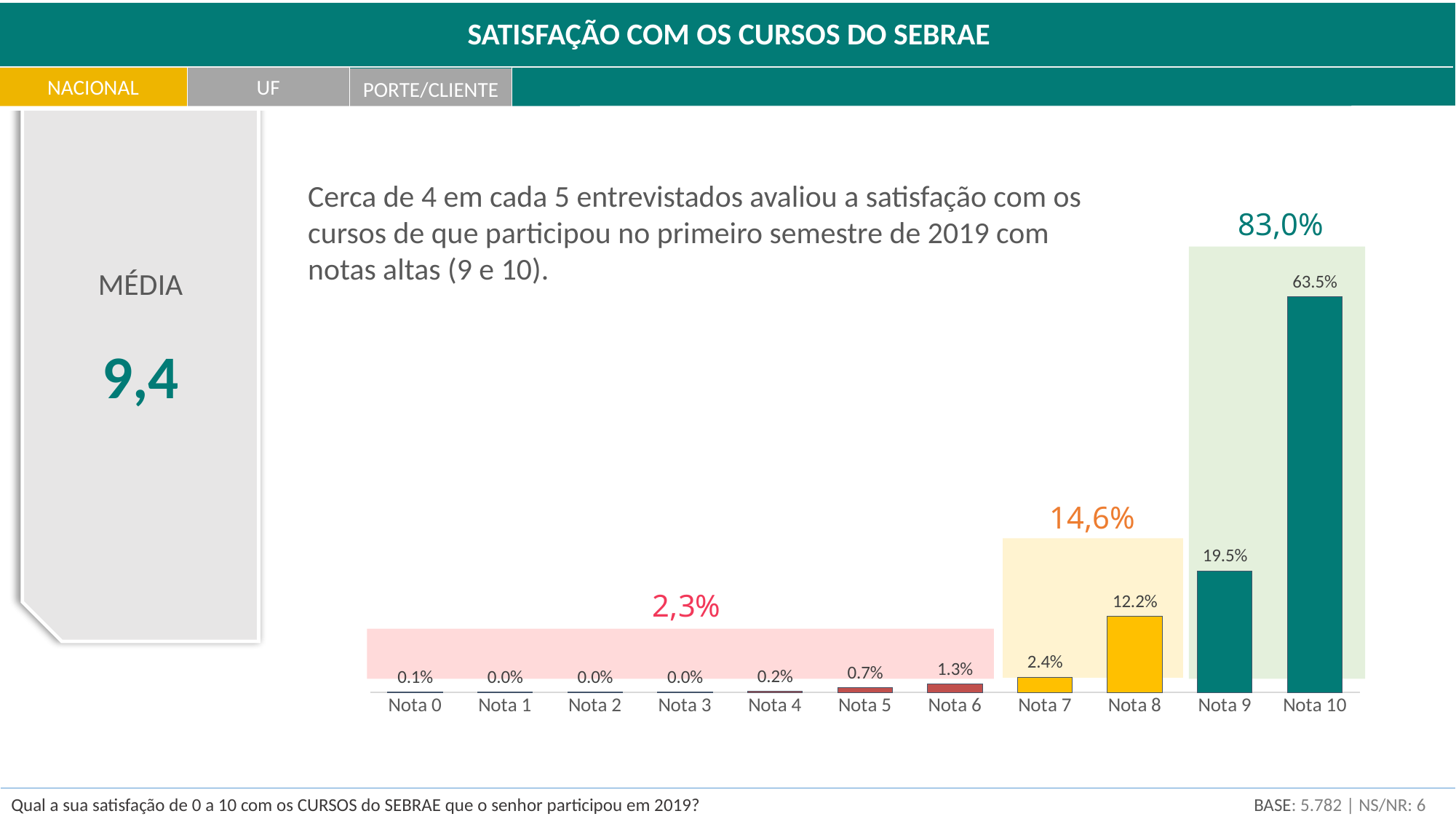
What is the value for Nota 9? 19.5% What is the value for Nota 10? 63.5% Which is larger, the value for Nota 8 or the value for Nota 7? Nota 8 What is the difference between the values for Nota 10 and Nota 9? 44.0% How many categories are shown on the x axis? 11 What is the value for Nota 6? 1.3% What is the combined share shown for Nota 7 and Nota 8 (the yellow group)? 14,6% What is the combined share shown for Nota 9 and Nota 10 (the green group)? 83,0% What kind of chart is shown? Bar chart Which category has the highest value? Nota 10 What is the value for Nota 7? 2.4% What is the value for Nota 8? 12.2%